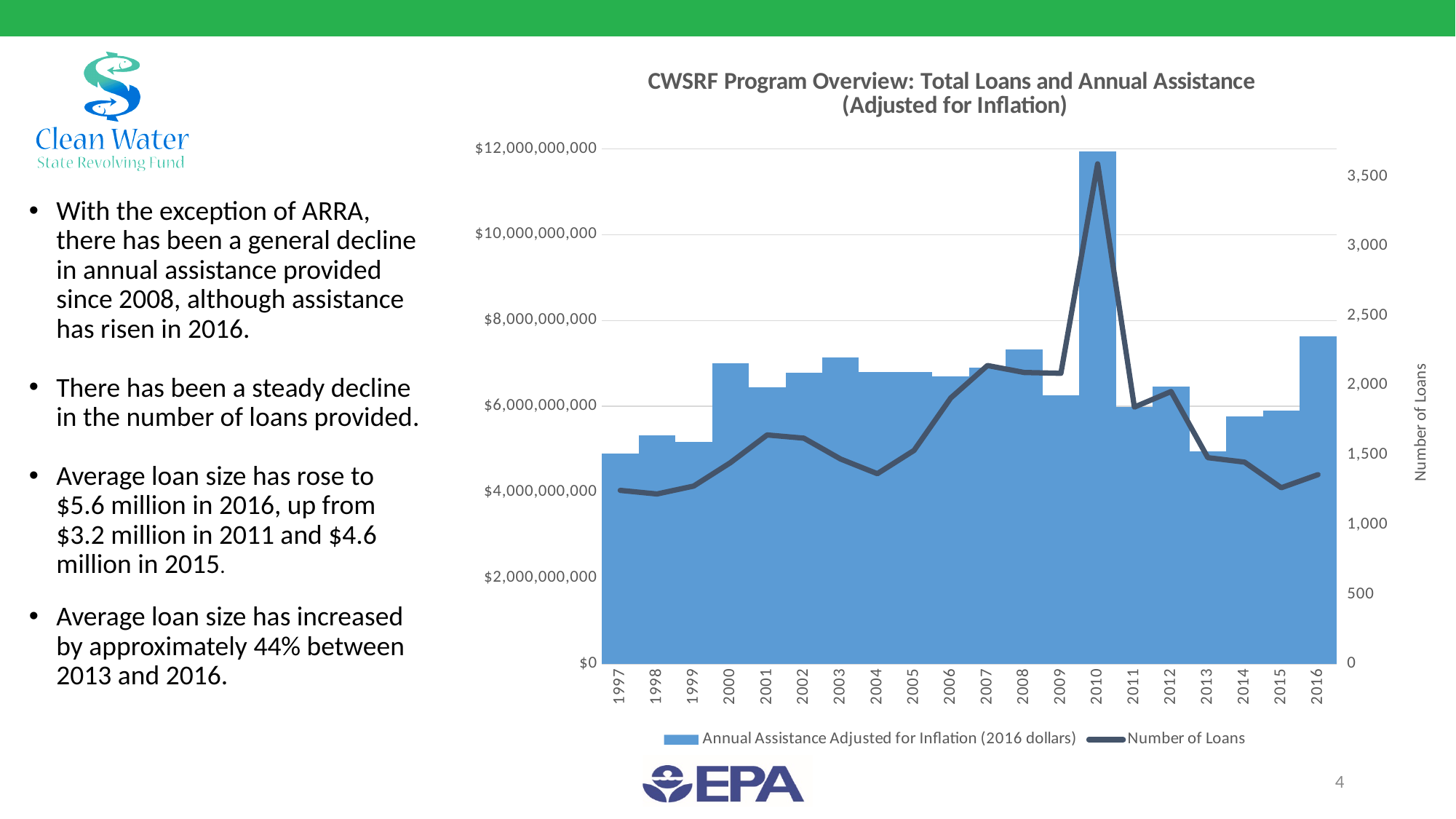
Which year has the larger Annual Assistance Adjusted for Inflation, 2015 or 2016? 2016 How many years are shown on the x axis of the chart? 20 Which year has the highest Number of Loans? 2010 What is the label of the right-hand vertical axis? Number of Loans How many series does the chart legend list? 2 Is the Annual Assistance Adjusted for Inflation in 2016 greater or less than $8,000,000,000? less Does the Number of Loans rise or fall from 2012 to 2015? Fall What kind of chart is shown on the slide? Combination bar and line chart Is the Number of Loans in 2010 greater or less than 3,000? greater Is the Annual Assistance Adjusted for Inflation in 2010 greater or less than $10,000,000,000? greater Which year has the highest Annual Assistance Adjusted for Inflation? 2010